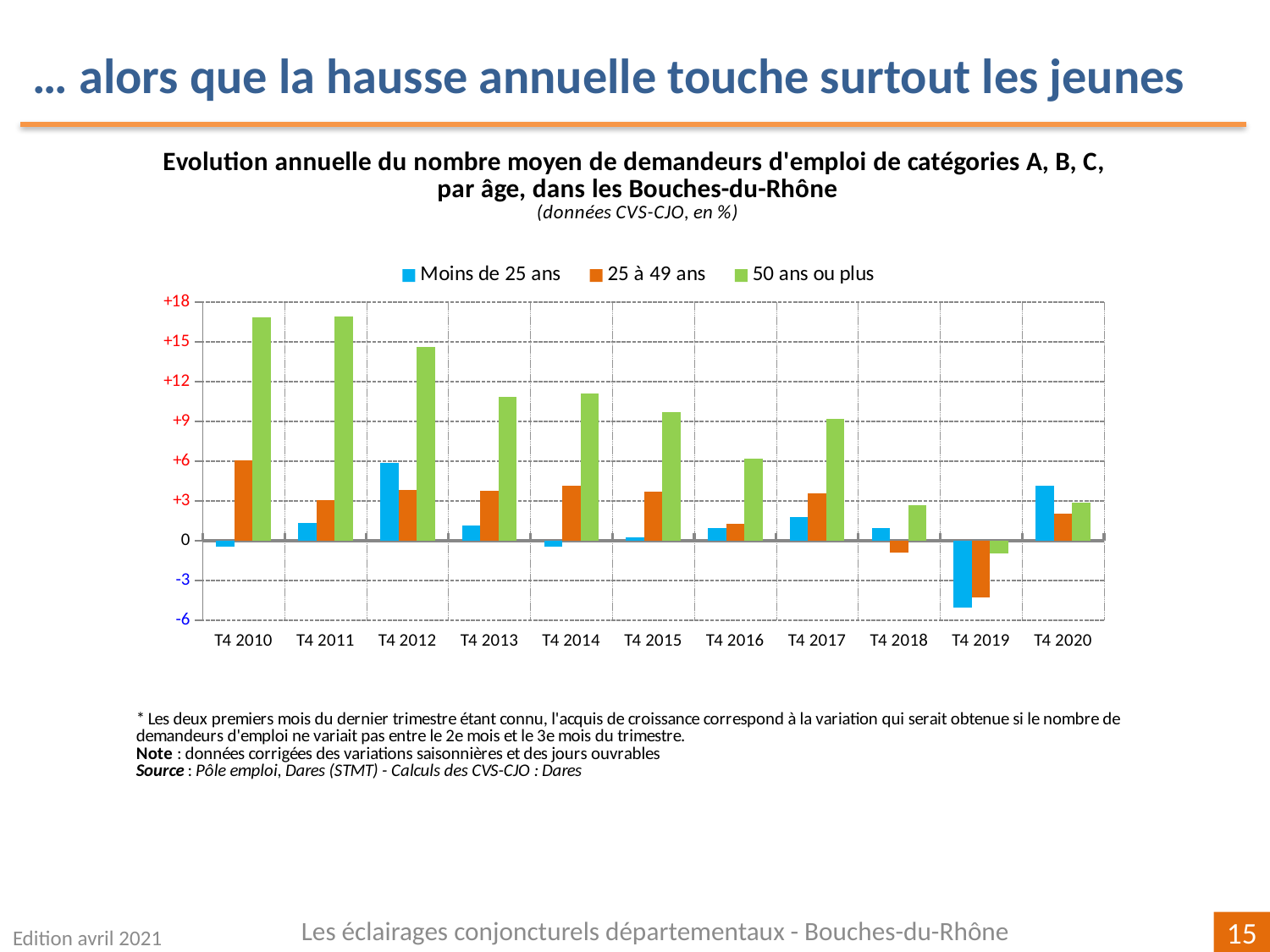
Does the value for '50 ans ou plus' overall rise or fall from T4 2010 to T4 2019? fall In which period is the value for 'Moins de 25 ans' the lowest? T4 2019 Which age group has the highest value in T4 2015? 50 ans ou plus How many quarters (T4 periods) are shown on the x axis? 11 Is the value for '25 à 49 ans' in T4 2010 greater or less than +3? greater Is the value for '50 ans ou plus' in T4 2010 greater or less than +15? greater What kind of chart is shown on the slide? Bar chart Is the value for '50 ans ou plus' in T4 2019 greater or less than 0? less In T4 2012, which is larger: the value for 'Moins de 25 ans' or for '25 à 49 ans'? Moins de 25 ans Which age group has the highest value in T4 2020? Moins de 25 ans How many series does the legend list? 3 What colour represents the '50 ans ou plus' series? Green